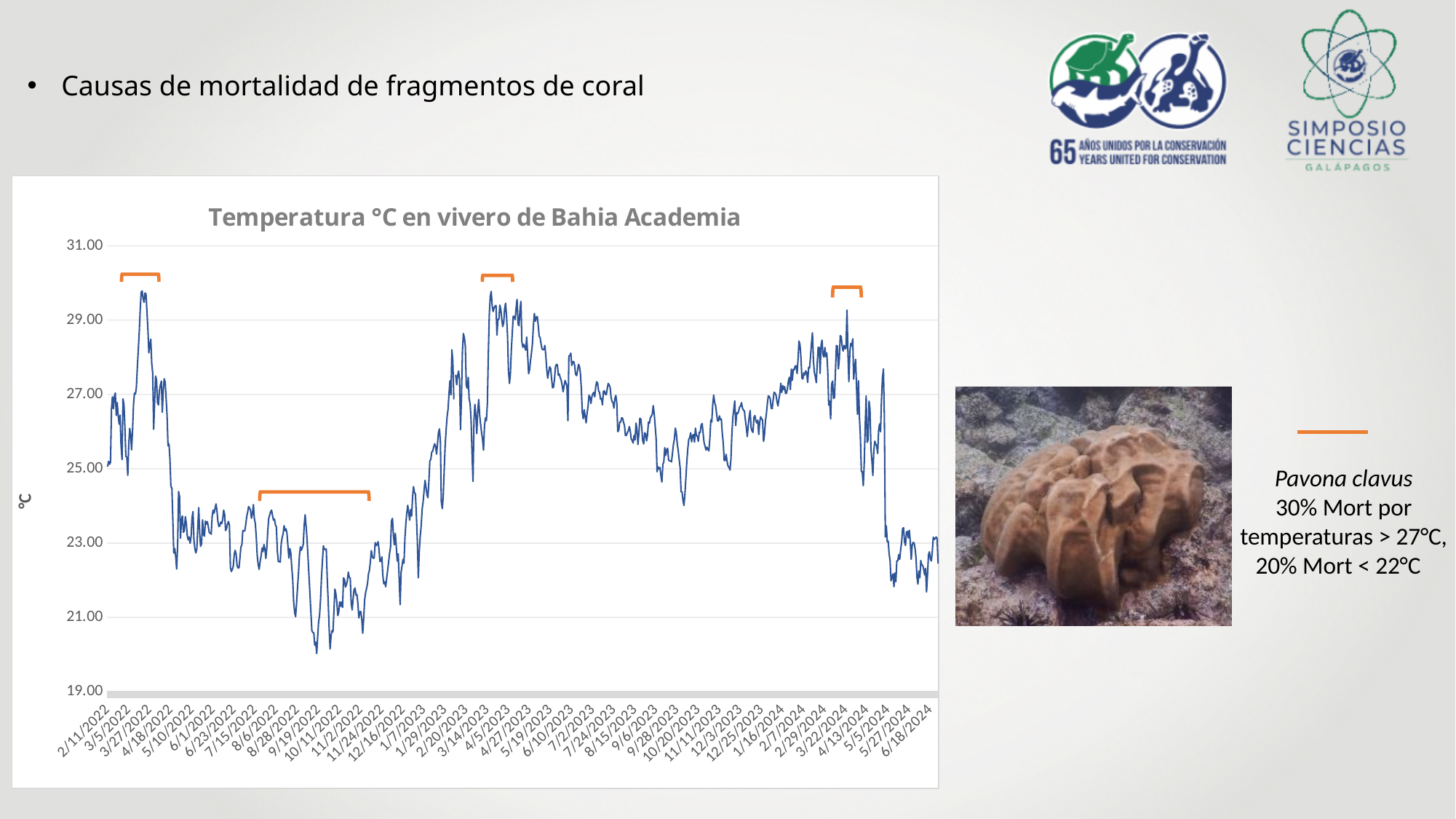
What kind of chart is shown on the slide? line chart What is the label on the vertical axis of the chart? °C Is the temperature around 9/19/2022 greater or less than 21.00? less Which is higher, the temperature around 4/5/2023 or the temperature around 9/19/2022? 4/5/2023 Around which date does the temperature reach its lowest point? 9/19/2022 Is the temperature at 6/18/2024 greater or less than 25.00? less Does the temperature rise or fall between 3/27/2022 and 9/19/2022? fall Is the temperature around 10/20/2023 greater or less than 27.00? less What is the title of the chart? Temperatura °C en vivero de Bahia Academia Does the temperature rise or fall between 9/19/2022 and 4/5/2023? rise